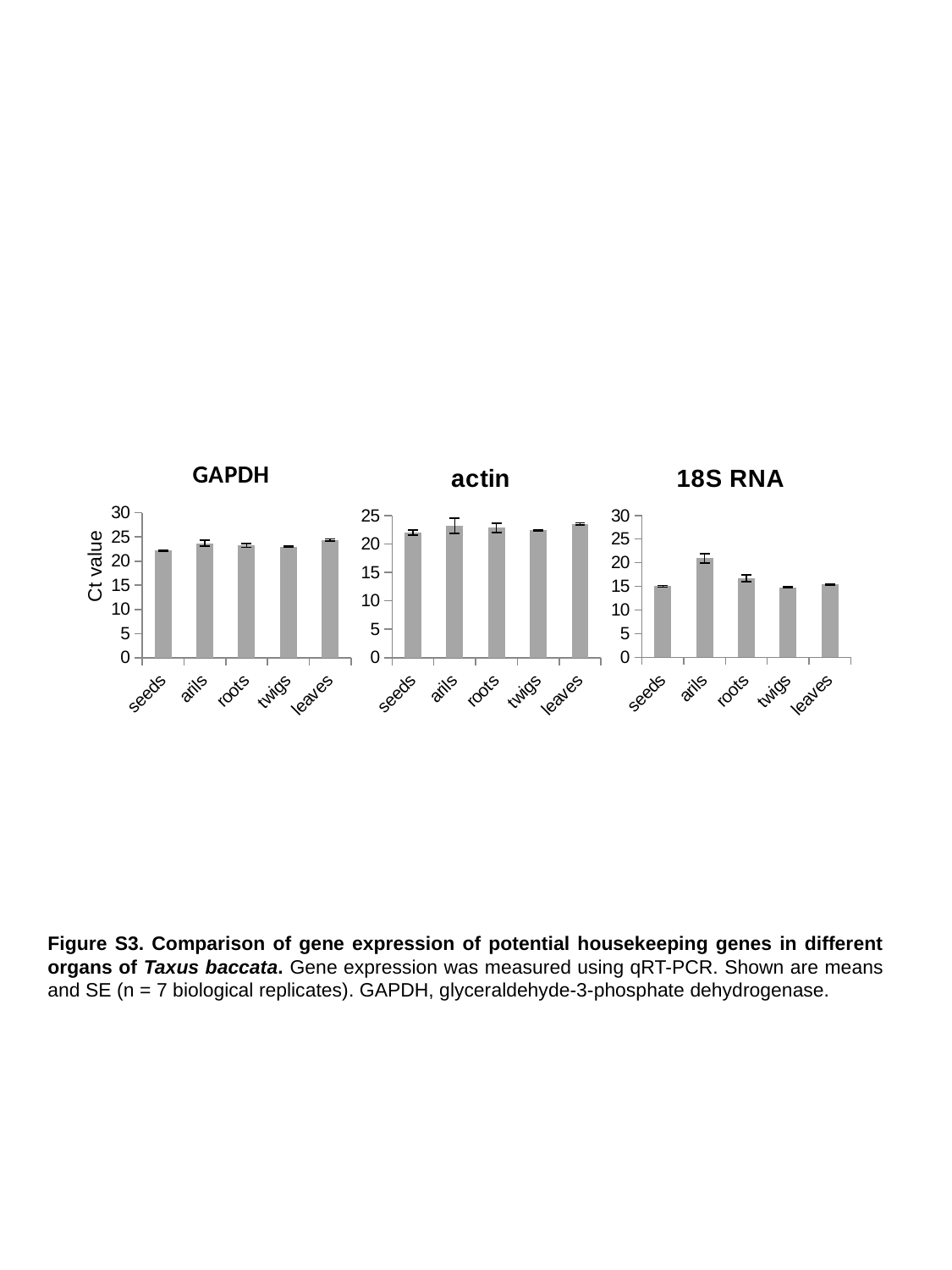
In the actin chart, is the value for twigs greater or less than 20? greater In the GAPDH chart, is the value for seeds greater or less than 20? greater In the 18S RNA chart, which category has the highest value? arils What is the y-axis label on the GAPDH chart? Ct value What kind of chart is the GAPDH chart? bar chart In the 18S RNA chart, is the value for seeds greater or less than 20? less How many categories are shown on the x axis of the actin chart? 5 In the 18S RNA chart, which is larger, the value for arils or the value for seeds? arils How many charts are shown on the slide? 3